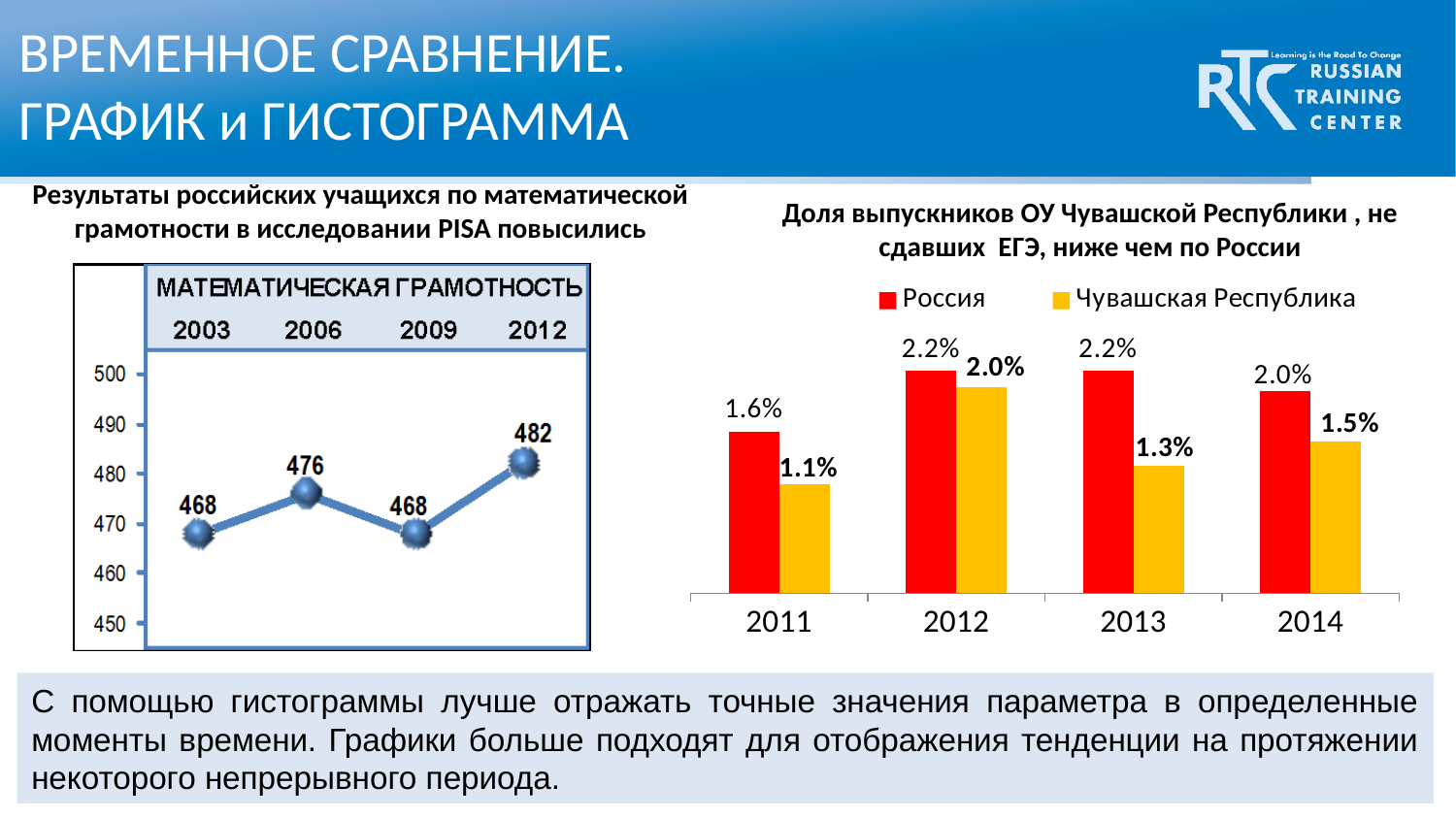
In the left chart (МАТЕМАТИЧЕСКАЯ ГРАМОТНОСТЬ), which year has the highest value? 2012 In the right chart (Доля выпускников ОУ Чувашской Республики, не сдавших ЕГЭ), how many series does the legend list? 2 What kind of chart is the left chart (МАТЕМАТИЧЕСКАЯ ГРАМОТНОСТЬ)? Line chart In the left chart (МАТЕМАТИЧЕСКАЯ ГРАМОТНОСТЬ), what is the difference between the values for 2012 and 2003? 14 In the right chart (Доля выпускников ОУ Чувашской Республики, не сдавших ЕГЭ), what is the value for Россия in 2011? 1.6% In the right chart (Доля выпускников ОУ Чувашской Республики, не сдавших ЕГЭ), what is the difference between Россия and Чувашская Республика in 2013? 0.9% In the right chart (Доля выпускников ОУ Чувашской Республики, не сдавших ЕГЭ), which year has the lowest value for Чувашская Республика? 2011 In the left chart (МАТЕМАТИЧЕСКАЯ ГРАМОТНОСТЬ), what is the value for 2012? 482 In the left chart (МАТЕМАТИЧЕСКАЯ ГРАМОТНОСТЬ), what is the value for 2006? 476 What kind of chart is the right chart (Доля выпускников ОУ Чувашской Республики, не сдавших ЕГЭ)? Bar chart In the left chart (МАТЕМАТИЧЕСКАЯ ГРАМОТНОСТЬ), how many years are plotted? 4 In the right chart (Доля выпускников ОУ Чувашской Республики, не сдавших ЕГЭ), what is the value for Чувашская Республика in 2013? 1.3%